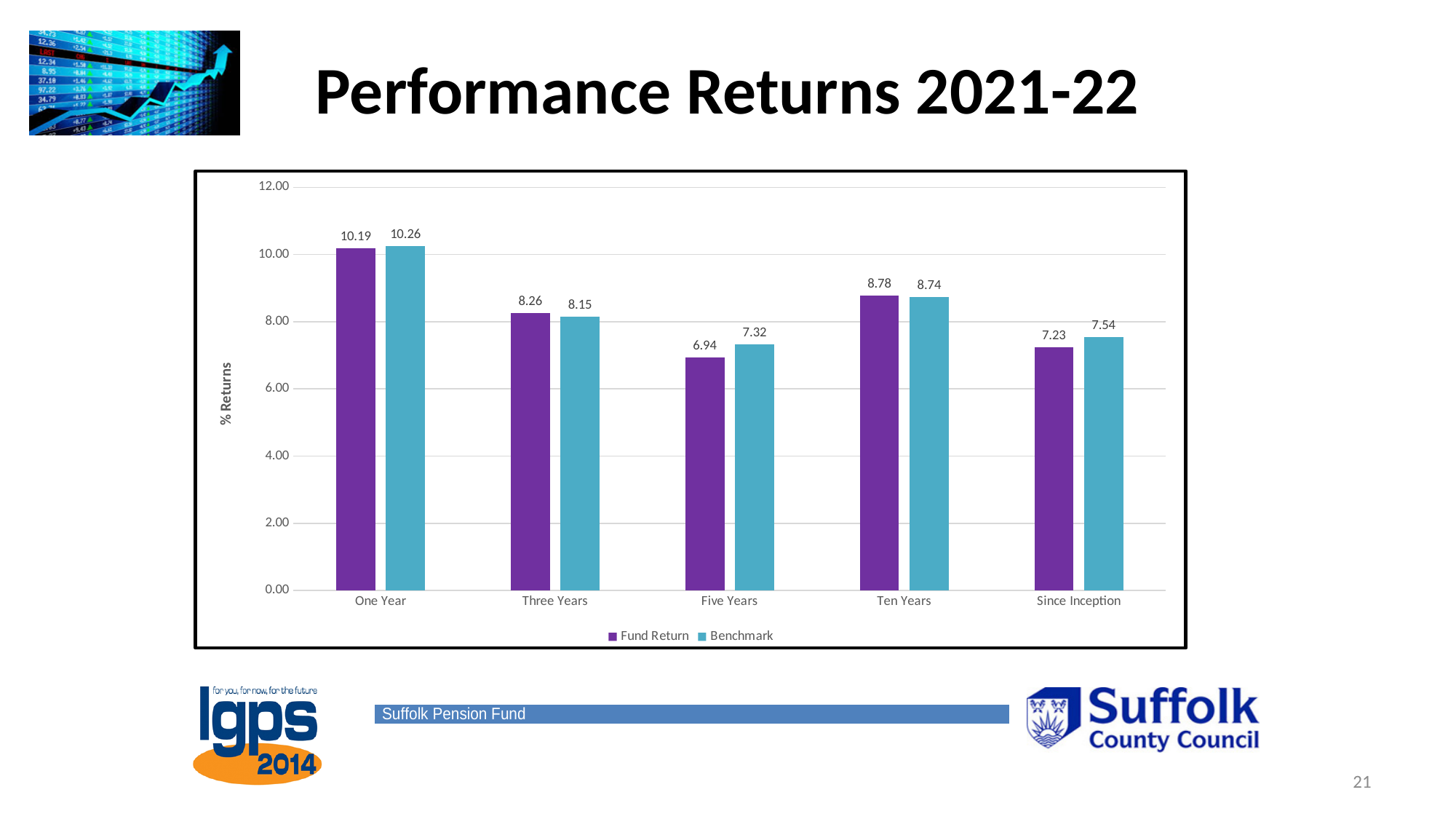
Which is larger for Ten Years, the Fund Return or the Benchmark? Fund Return What is the Fund Return value for Since Inception? 7.23 What is the label of the vertical axis? % Returns Which category has the lowest Benchmark value? Five Years Which category has the highest Fund Return? One Year How many categories are shown on the x axis? 5 What is the difference between the Benchmark and Fund Return values for Since Inception? 0.31 What is the difference between the Fund Return and Benchmark values for Three Years? 0.11 What kind of chart is shown on the slide? Bar chart How many series does the legend list? 2 What is the Benchmark value for Five Years? 7.32 What is the Fund Return value for One Year? 10.19